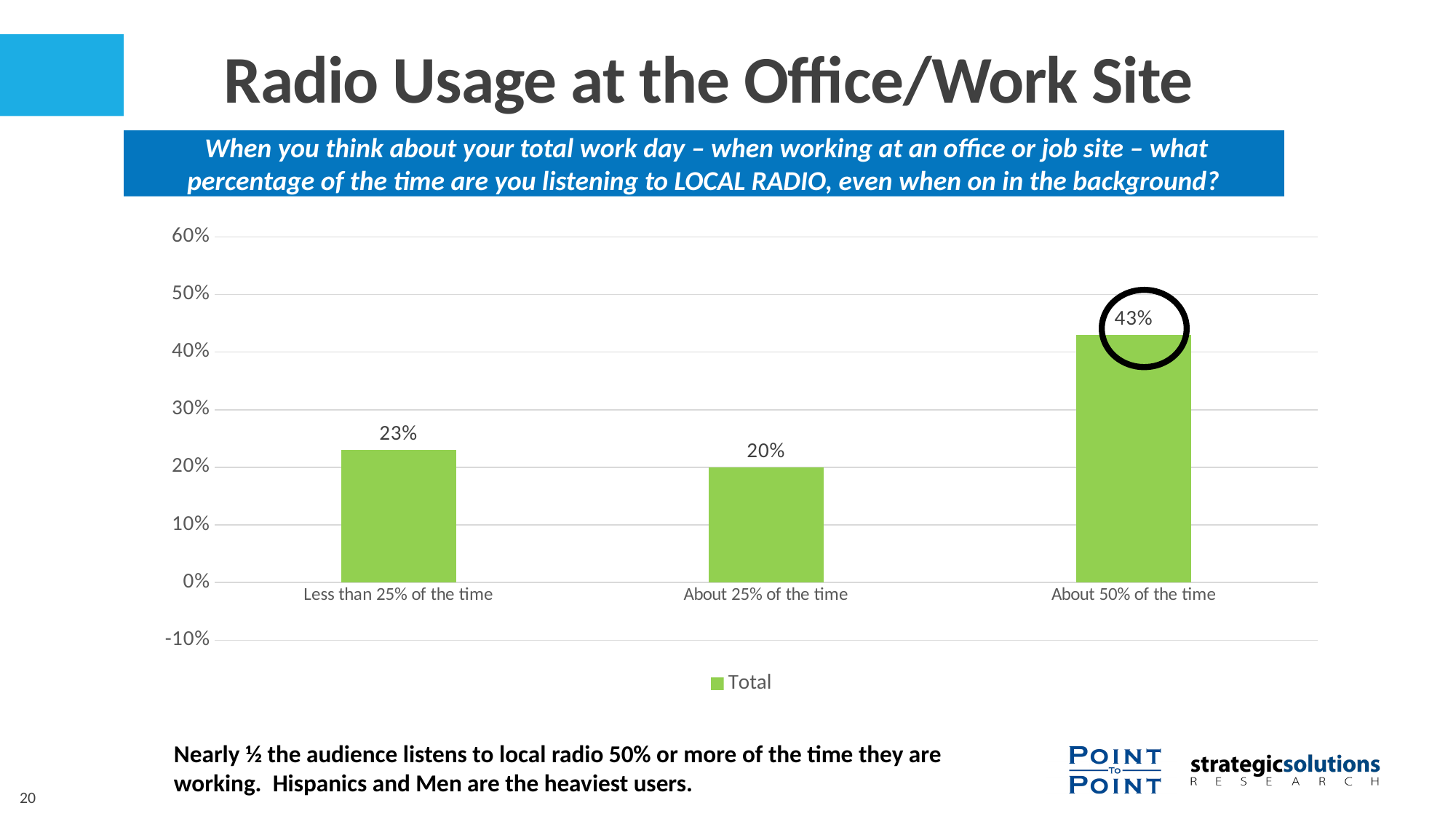
Which category has the lowest value? About 25% of the time What is the value for "Less than 25% of the time"? 23% What kind of chart is shown on the slide? bar chart What is the value for "About 50% of the time"? 43% How many categories are shown on the x axis? 3 What is the value for "About 25% of the time"? 20% Which category has the highest value? About 50% of the time Which is larger, the value for "Less than 25% of the time" or "About 25% of the time"? Less than 25% of the time Is the value for "About 50% of the time" greater or less than 40%? greater What is the difference between the values for "About 50% of the time" and "Less than 25% of the time"? 20% How many series does the legend list? 1 What is the difference between the values for "Less than 25% of the time" and "About 25% of the time"? 3%